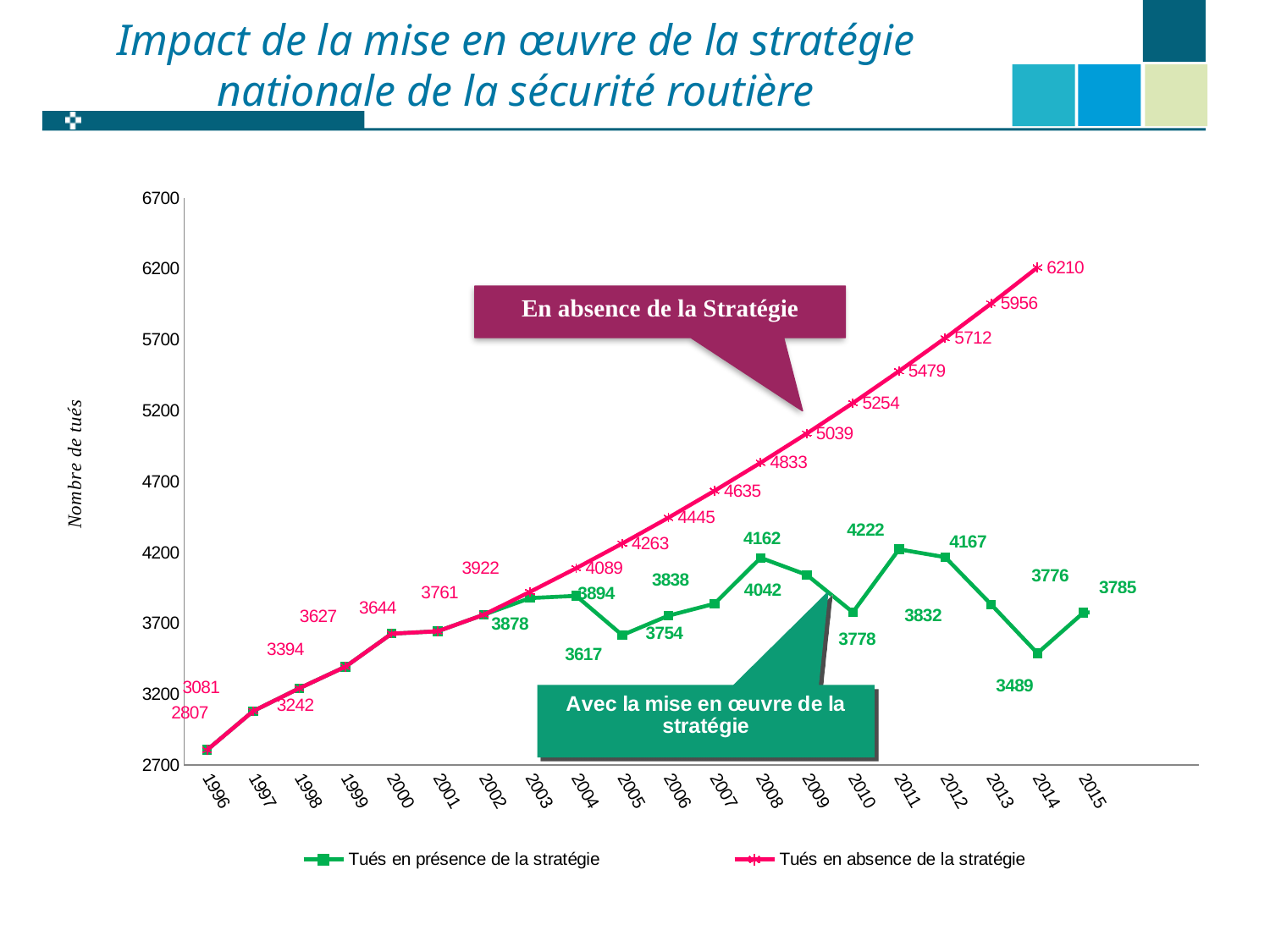
What is the difference between 'Tués en absence de la stratégie' and 'Tués en présence de la stratégie' in 2014? 2721 What is the value of 'Tués en absence de la stratégie' in 2014? 6210 In which year does 'Tués en présence de la stratégie' reach its highest value? 2011 In which year does 'Tués en absence de la stratégie' reach its highest value? 2014 Does 'Tués en absence de la stratégie' rise or fall from 1996 to 2014? rise What is the value of 'Tués en absence de la stratégie' in 2010? 5254 What is the value of 'Tués en présence de la stratégie' in 2014? 3489 In 2010, which series has the larger value: 'Tués en absence de la stratégie' or 'Tués en présence de la stratégie'? Tués en absence de la stratégie What is the value of 'Tués en présence de la stratégie' in 2011? 4222 How many years are shown on the x axis? 20 How many series does the legend list? 2 What kind of chart is shown on the slide? line chart